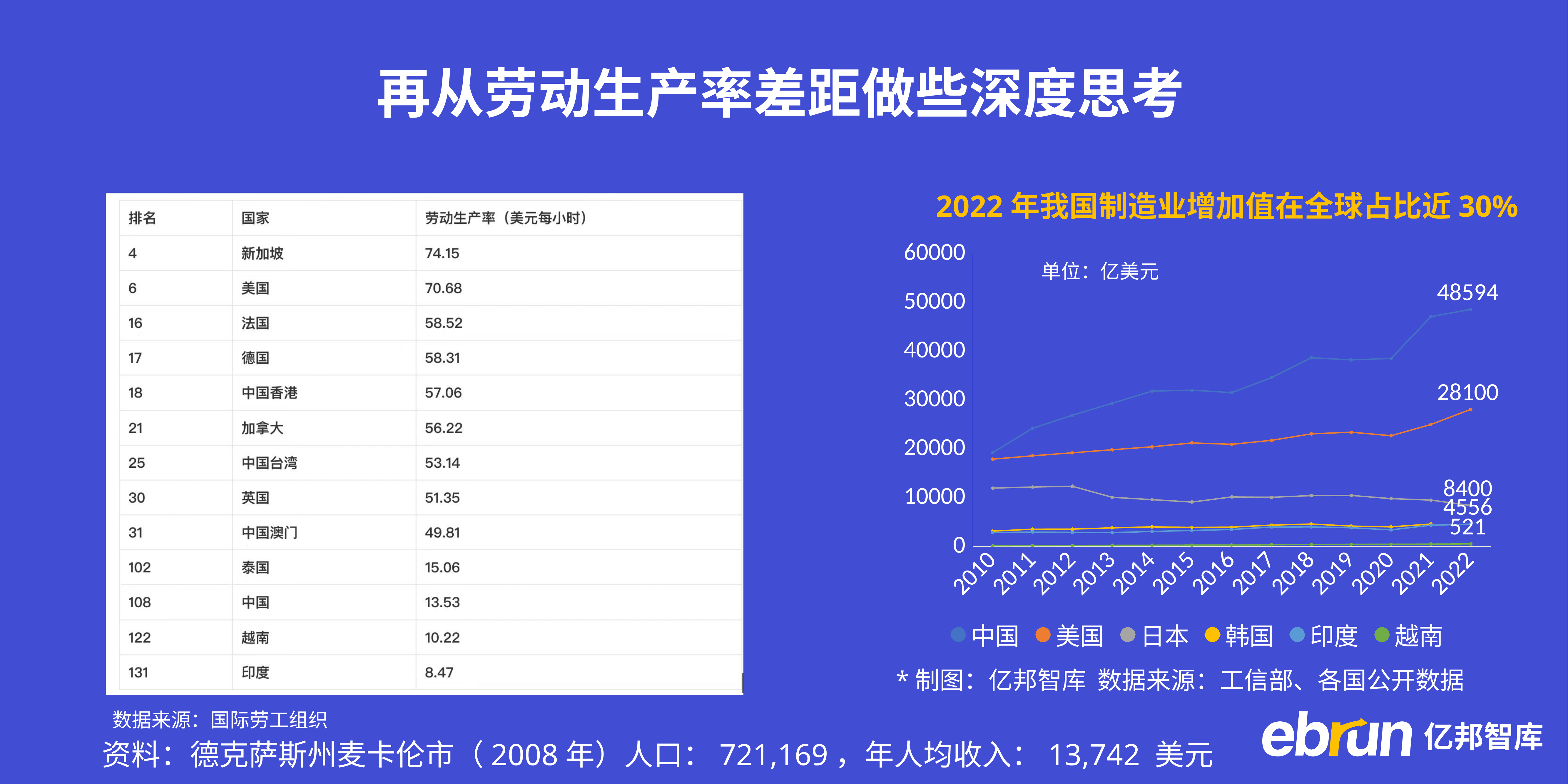
What unit is stated on the line chart? 亿美元 In the line chart, is the value for 美国 in 2010 greater or less than 20000? less In the line chart, what is the value for 日本 in 2022? 8400 How many series does the legend of the line chart list? 6 In the line chart, what is the value for 美国 in 2022? 28100 What kind of chart is shown on the right side of the slide? line chart In the line chart, which series has the highest value in 2022? 中国 In the line chart, which series has the lowest values across the years? 越南 How many years are shown on the x axis of the line chart? 13 In the line chart, does the value for 中国 generally rise or fall from 2010 to 2022? rise In the line chart, what is the difference between the 2022 values for 中国 and 美国? 20494 In the line chart, what is the value for 中国 in 2022? 48594